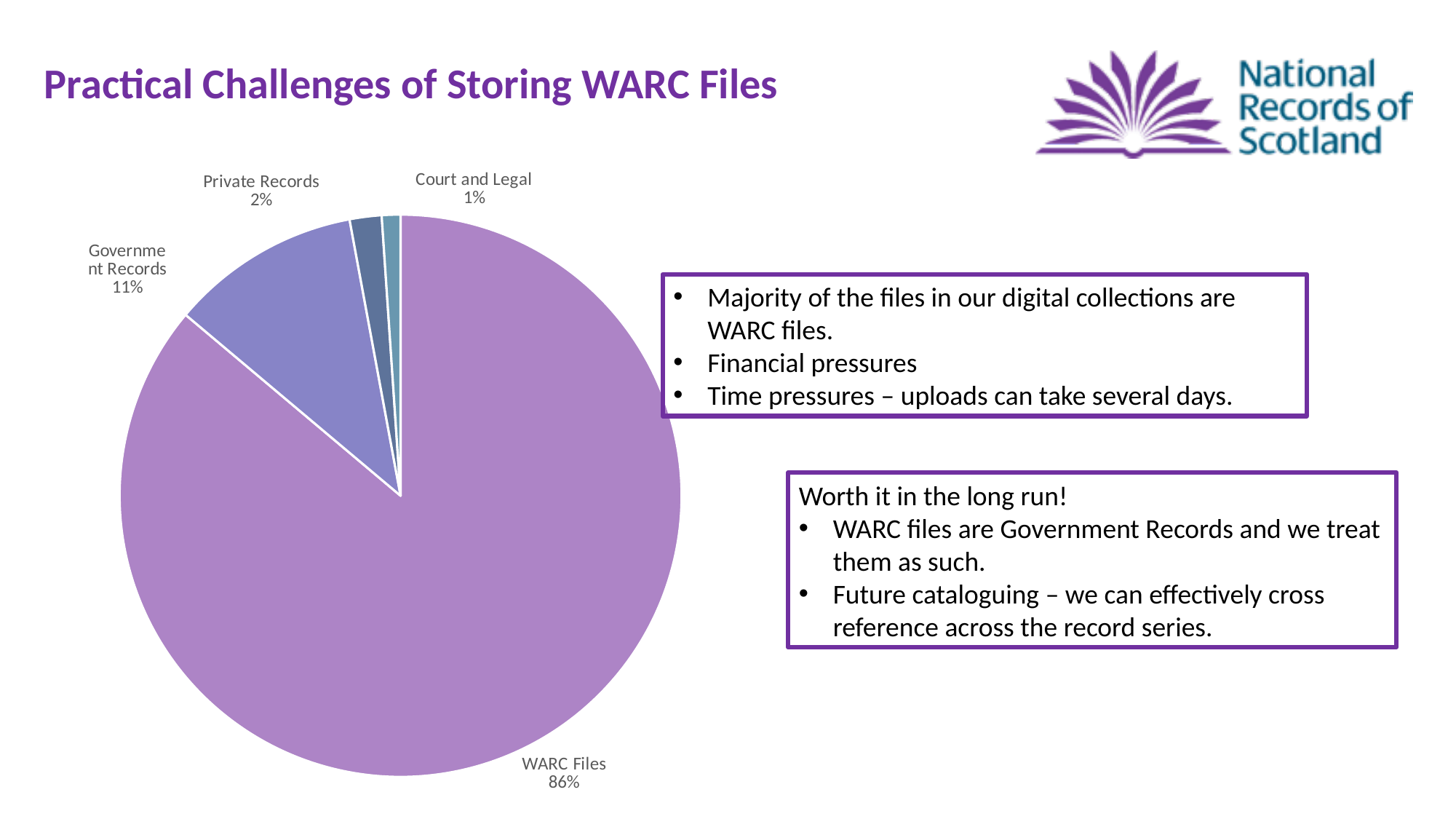
What is the title of the slide containing the pie chart? Practical Challenges of Storing WARC Files What is the difference in percentage points between Private Records and Court and Legal? 1 What share of the pie is Government Records? 11% Which category has the largest slice of the pie? WARC Files What kind of chart is shown on the slide? pie chart Which category has the smallest slice of the pie? Court and Legal What is the difference in percentage points between WARC Files and Government Records? 75 What share of the pie is Private Records? 2% How many slices does the pie chart have? 4 What share of the pie is Court and Legal? 1% Which is larger, the share for Government Records or the share for Private Records? Government Records